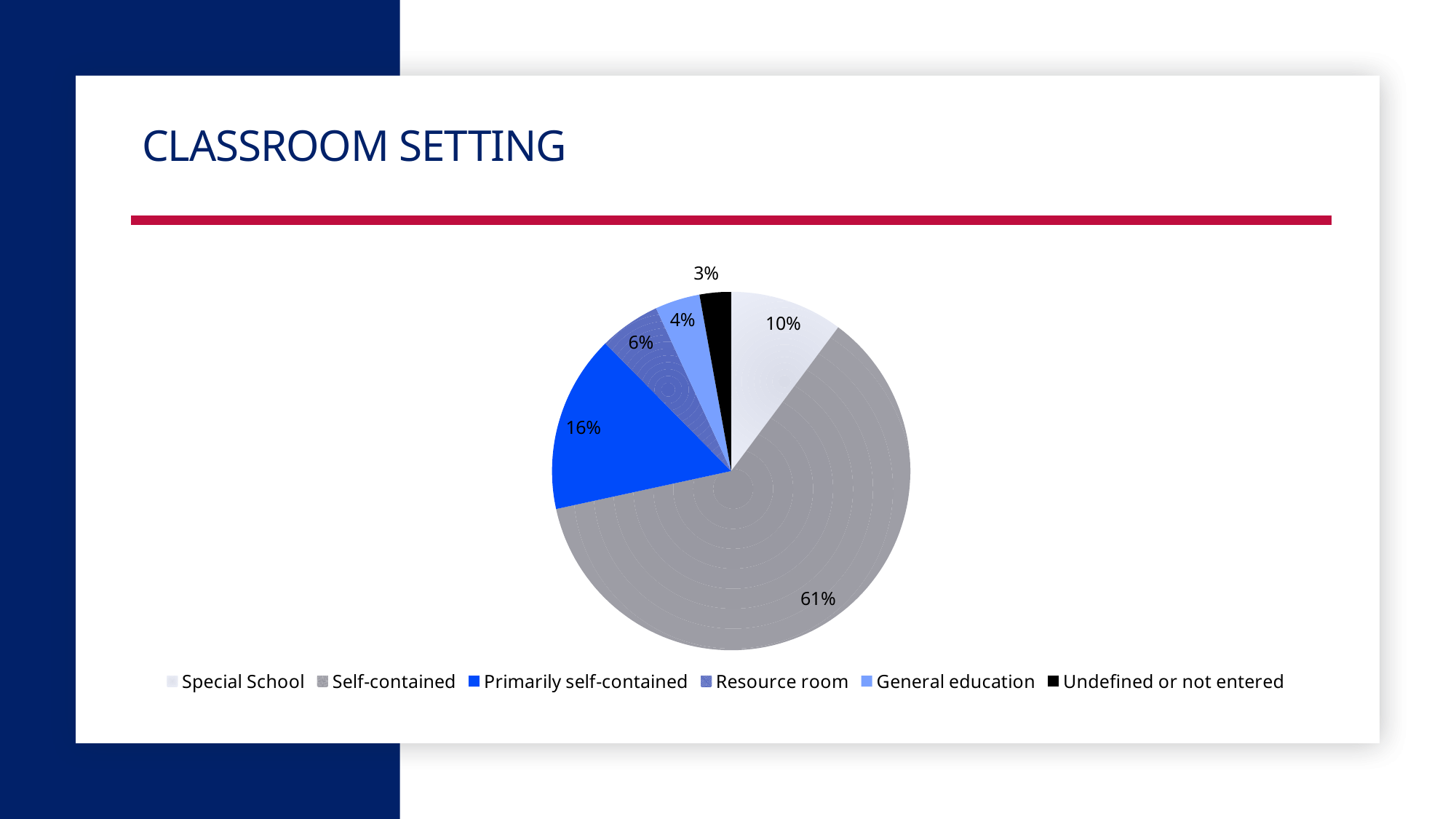
What share of the pie is Special School? 10% How many categories does the legend list? 6 What share of the pie is Primarily self-contained? 16% Which category has the largest slice of the pie? Self-contained What kind of chart is shown on the slide? pie chart What share of the pie is Self-contained? 61% What share of the pie is Resource room? 6% What share of the pie is Undefined or not entered? 3% What share of the pie is General education? 4% What is the difference in percentage points between Self-contained and Primarily self-contained? 45 Which is larger, Special School or Resource room? Special School Which category has the smallest slice of the pie? Undefined or not entered